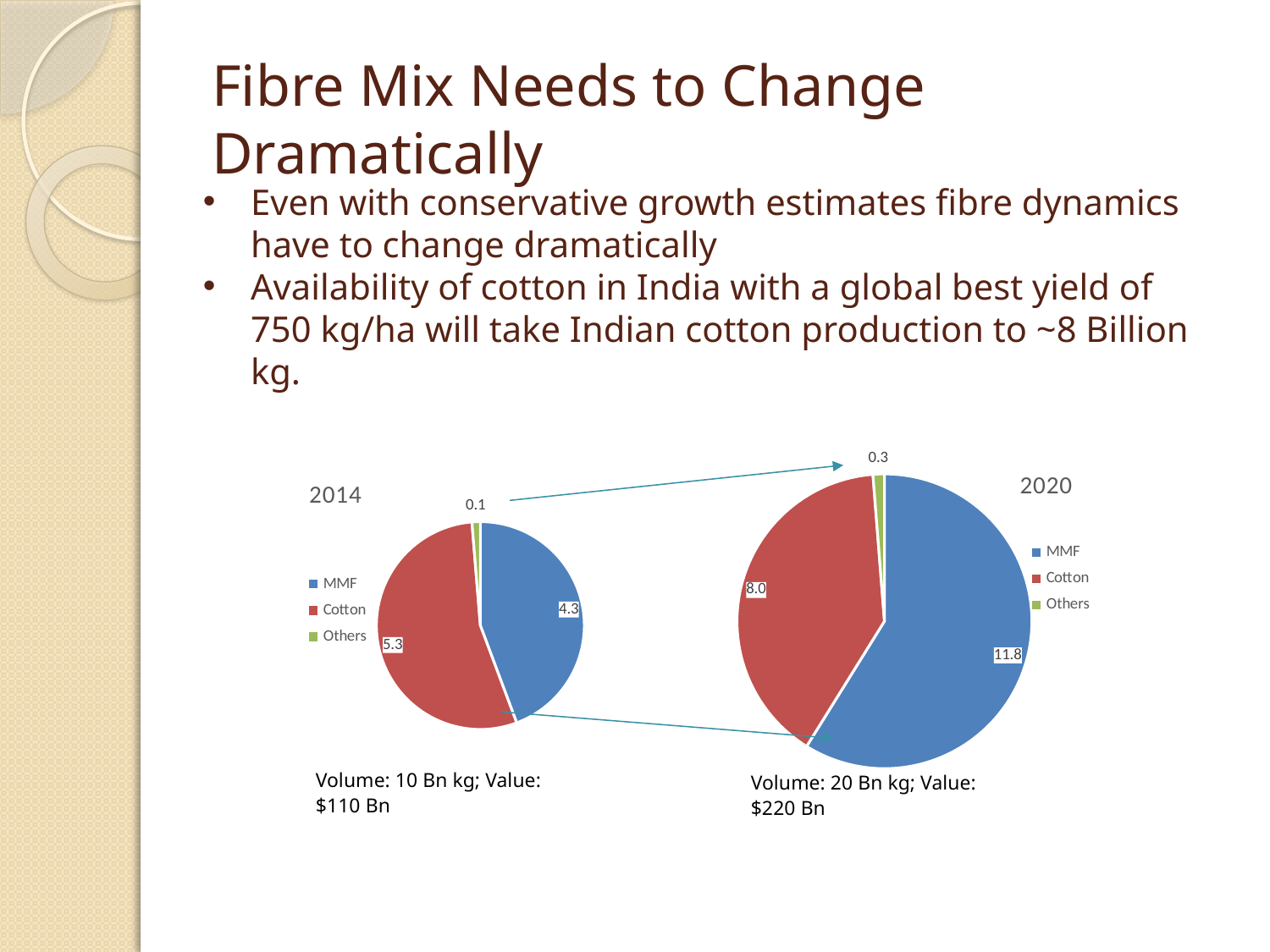
In the 2020 pie chart, which category has the smallest slice? Others In the 2020 pie chart, what is the value for Others? 0.3 In the 2014 pie chart, which is larger, MMF or Cotton? Cotton In the 2014 pie chart, what is the value for MMF? 4.3 What type of chart is used for the 2014 data? Pie chart In the 2014 pie chart, what is the value for Cotton? 5.3 In the 2020 pie chart, what is the difference between the MMF and Cotton values? 3.8 In the 2014 pie chart, which category has the largest slice? Cotton What colour represents Cotton in the pie charts? Red In the 2020 pie chart, what is the value for MMF? 11.8 How many categories does the 2020 pie chart show? 3 By how much does the MMF value increase from the 2014 chart to the 2020 chart? 7.5